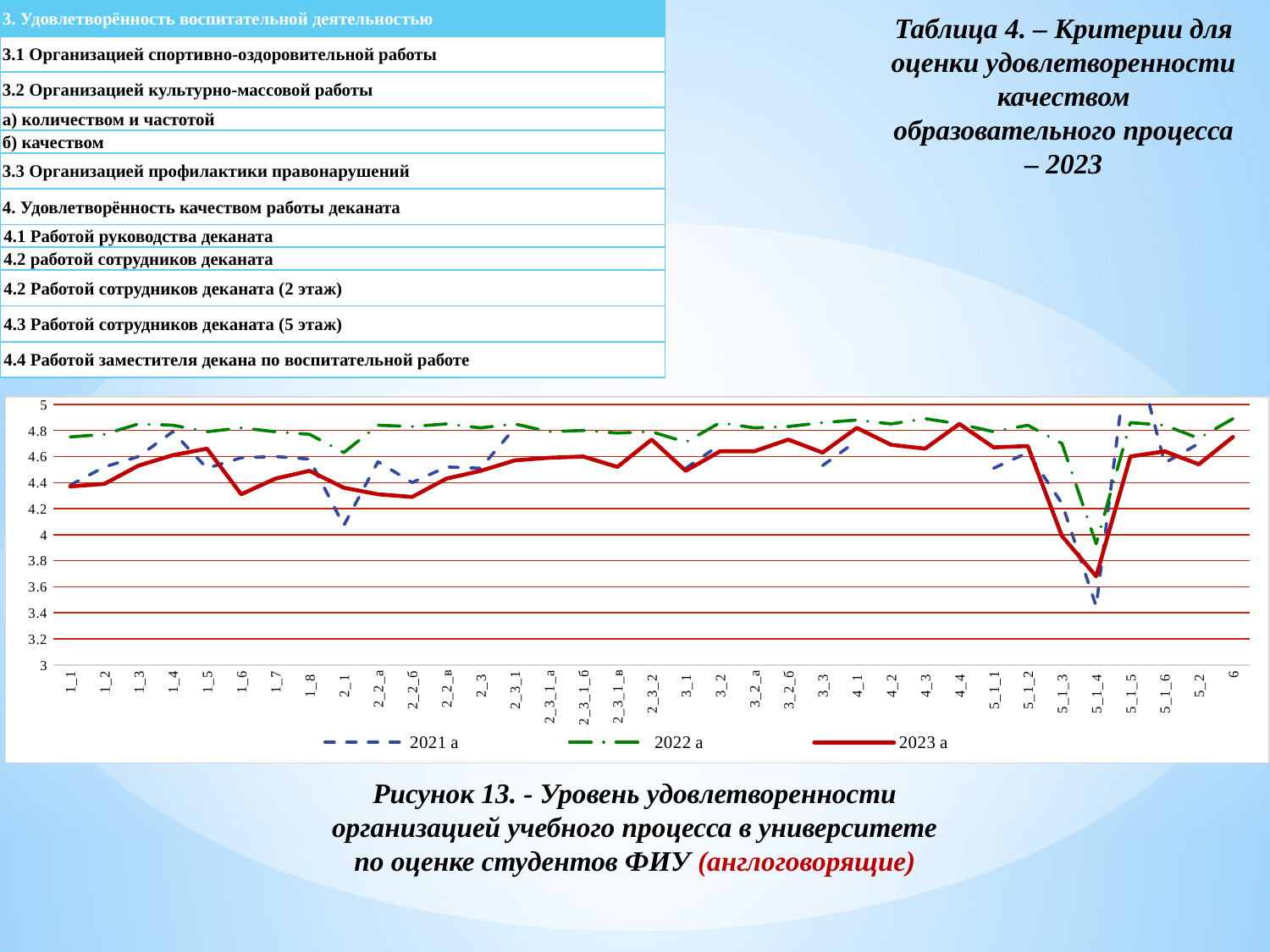
How many series does the chart legend list? 3 Is the value of the 2022 a series at 1_1 greater or less than 4.6? greater What are the series names listed in the chart legend? 2021 a, 2022 a, 2023 a What kind of chart is shown on the slide? line chart Is the value of the 2023 a series at 5_1_4 greater or less than 4? less Is the value of the 2023 a series at 4_4 greater or less than 4.6? greater At category 2_1, which series has the larger value: 2021 a or 2022 a? 2022 a At category 1_6, which series has the larger value: 2022 a or 2023 a? 2022 a Does the 2023 a series rise or fall from 5_1_2 to 5_1_4? fall At which category does the 2023 a series reach its lowest value? 5_1_4 How many categories are shown along the x axis of the chart? 35